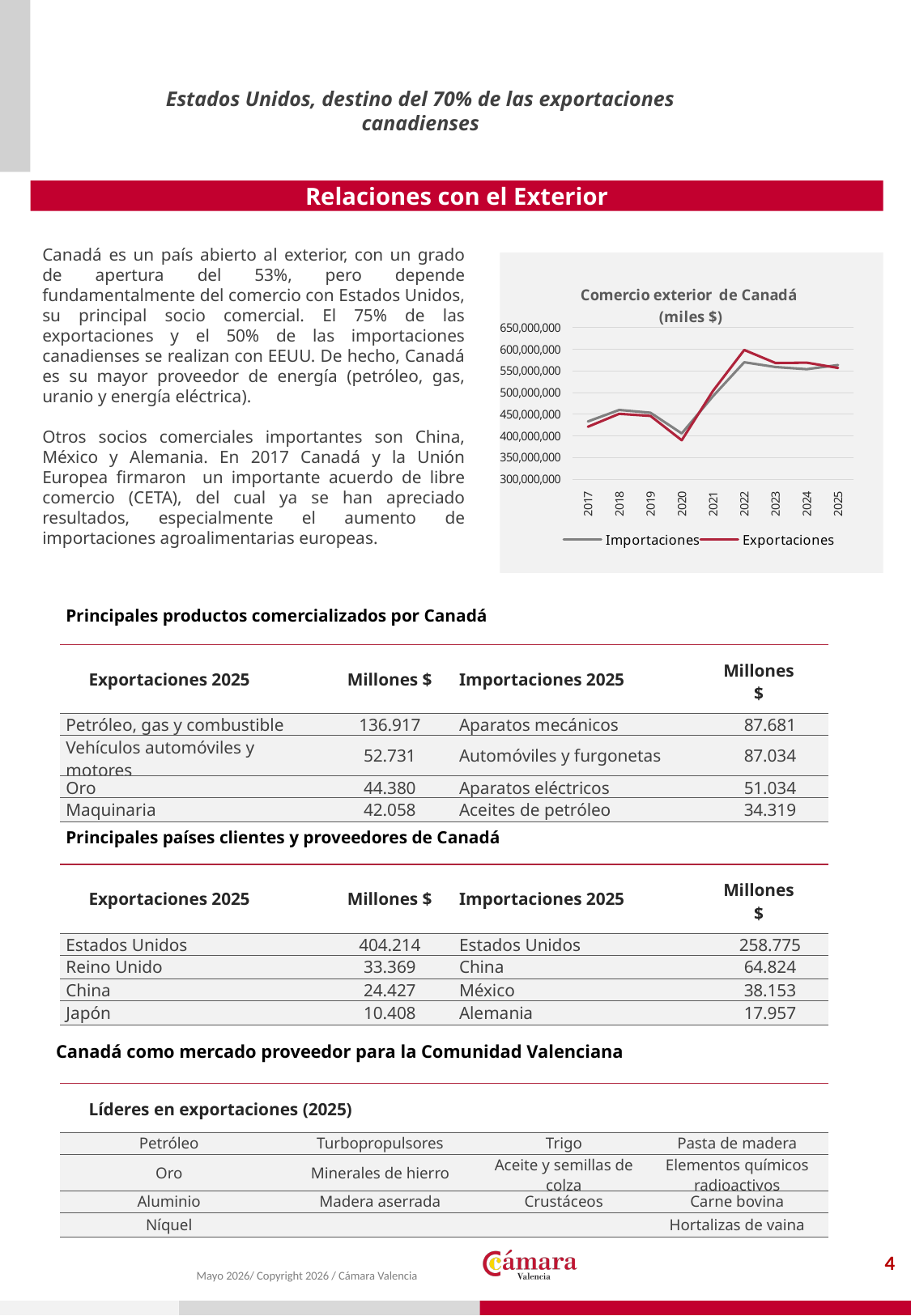
In the 'Comercio exterior de Canadá' chart, is the Importaciones value for 2025 greater or less than 500,000,000? greater What colour is the Exportaciones line in the 'Comercio exterior de Canadá' chart? red In the 'Comercio exterior de Canadá' chart, is the Exportaciones value for 2020 greater or less than 400,000,000? less How many series does the legend of the 'Comercio exterior de Canadá' chart list? 2 In the 'Comercio exterior de Canadá' chart, which series is higher in 2022, Importaciones or Exportaciones? Exportaciones In the 'Comercio exterior de Canadá' chart, do the Exportaciones values rise or fall from 2020 to 2022? rise In the 'Comercio exterior de Canadá' chart, in which year is the Exportaciones series lowest? 2020 In the 'Comercio exterior de Canadá' chart, in which year is the Exportaciones series highest? 2022 In the 'Comercio exterior de Canadá' chart, is the Exportaciones value for 2017 greater or less than 450,000,000? less What kind of chart is 'Comercio exterior de Canadá (miles $)'? line chart How many years are shown on the x axis of the 'Comercio exterior de Canadá' chart? 9